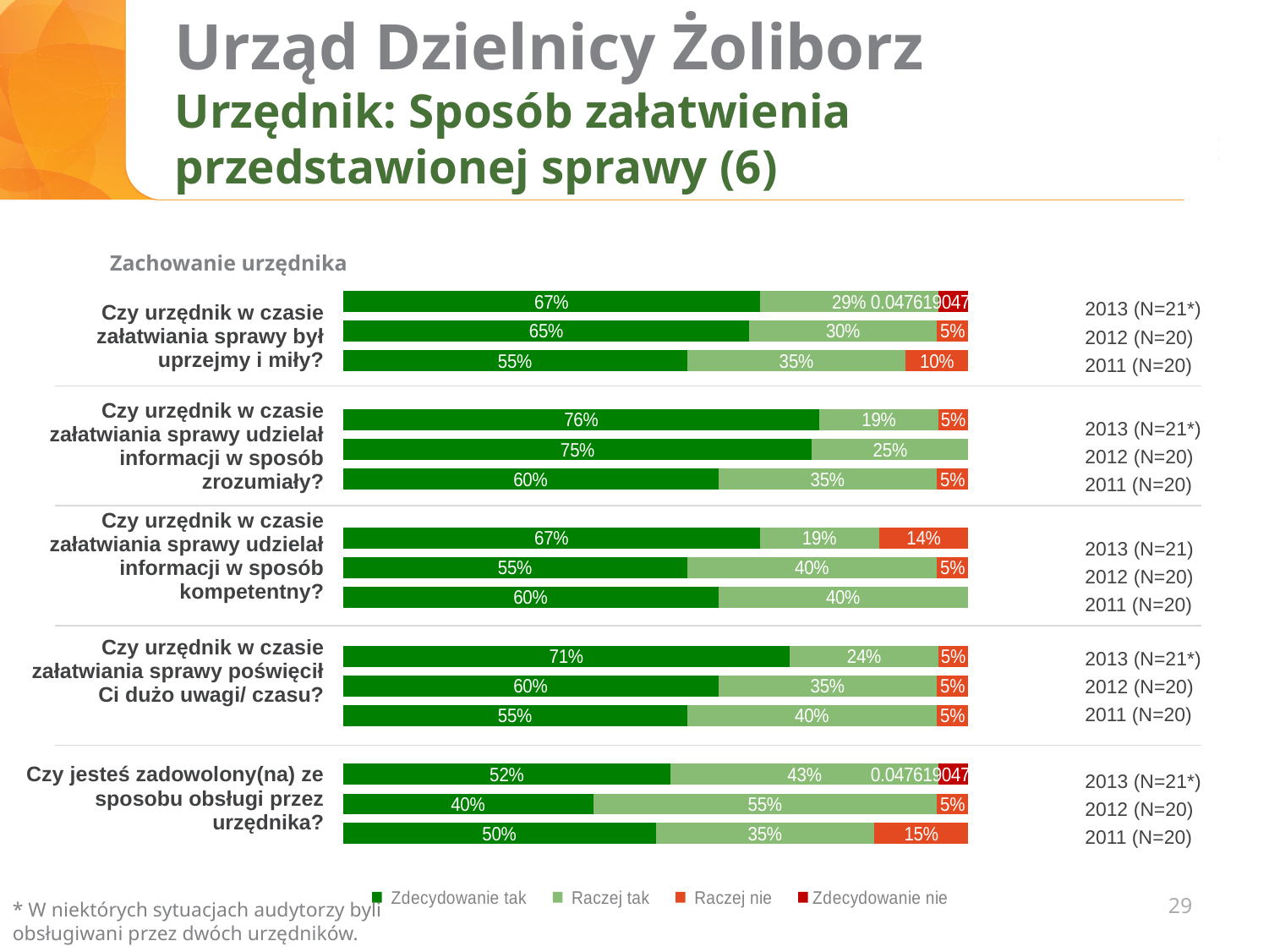
How many series does the legend list? 4 For the question 'Czy urzędnik w czasie załatwiania sprawy poświęcił Ci dużo uwagi/ czasu?', what is the difference between the 'Zdecydowanie tak' values for 2013 and 2011? 16% What is the 'Raczej nie' value for 2011 for the question 'Czy jesteś zadowolony(na) ze sposobu obsługi przez urzędnika?' 15% What is the sample size (N) shown for 2012 for each question? N=20 For the question 'Czy urzędnik w czasie załatwiania sprawy udzielał informacji w sposób kompetentny?', which year has the highest 'Zdecydowanie tak' value? 2013 What kind of chart is shown on the slide? Stacked bar chart What is the 'Zdecydowanie tak' value for 2013 for the question 'Czy urzędnik w czasie załatwiania sprawy udzielał informacji w sposób zrozumiały?' 76% For the question 'Czy urzędnik w czasie załatwiania sprawy udzielał informacji w sposób kompetentny?', what is the total of the 2011 bar? 100% For the question 'Czy jesteś zadowolony(na) ze sposobu obsługi przez urzędnika?', which year has the lowest 'Zdecydowanie tak' value? 2012 For the question 'Czy urzędnik w czasie załatwiania sprawy poświęcił Ci dużo uwagi/ czasu?', does the 'Zdecydowanie tak' value rise or fall from 2011 to 2013? Rise For the question 'Czy urzędnik w czasie załatwiania sprawy był uprzejmy i miły?', is the 'Zdecydowanie tak' value larger in 2012 or in 2011? 2012 What is the 'Raczej tak' value for 2012 for the question 'Czy jesteś zadowolony(na) ze sposobu obsługi przez urzędnika?' 55%